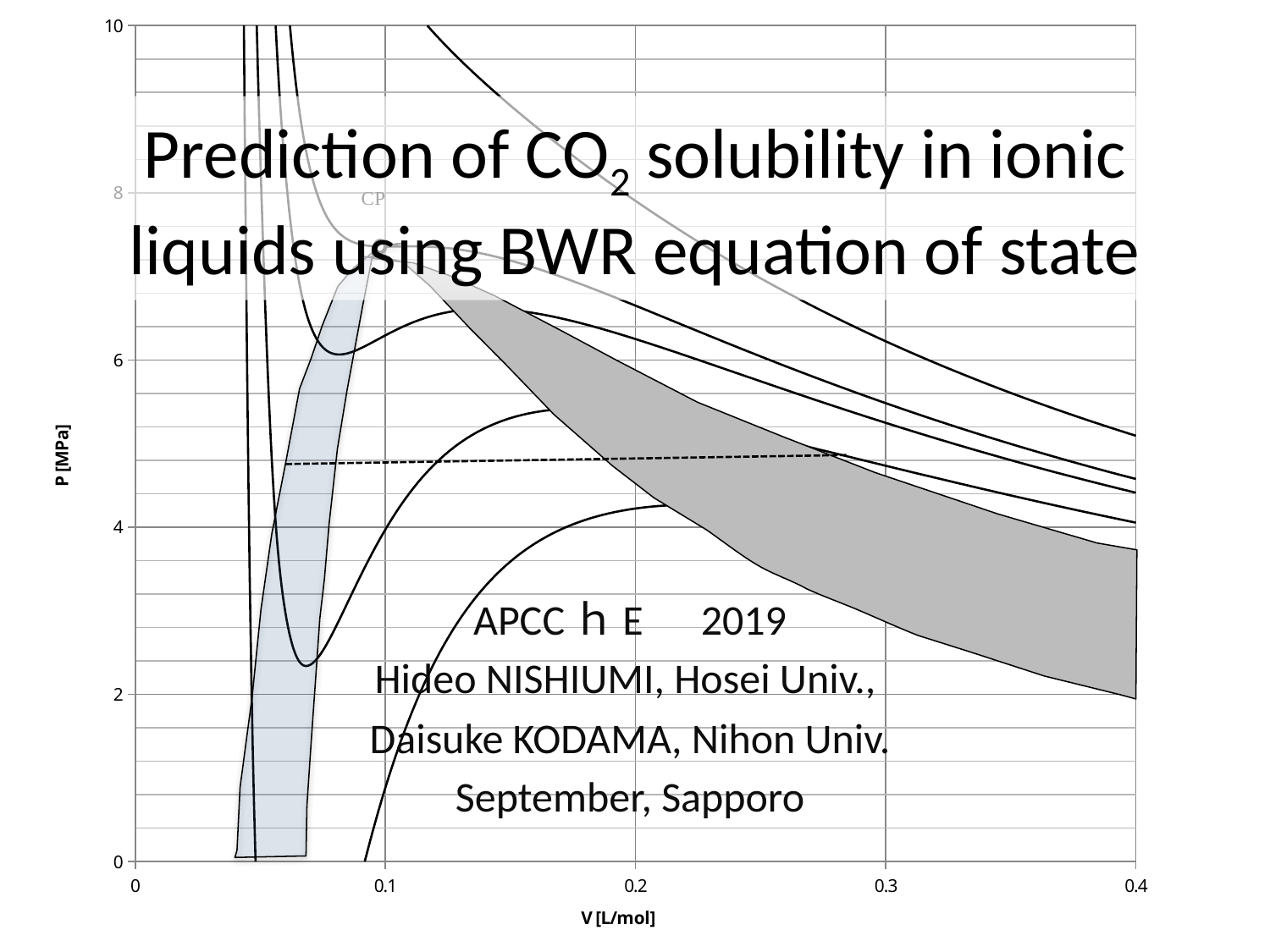
What is the title of the vertical axis of the chart? P [MPa] Is the pressure at the point labelled CP on the chart greater or less than 6 MPa? greater What kind of chart is shown on the slide? line chart Is the pressure of the horizontal dashed line on the chart greater or less than 4 MPa? greater Between V = 0.2 and V = 0.4 L/mol, do the plotted curves rise or fall as V increases? fall Is the pressure of the horizontal dashed line on the chart greater or less than 6 MPa? less What is the title of the horizontal axis of the chart? V [L/mol]